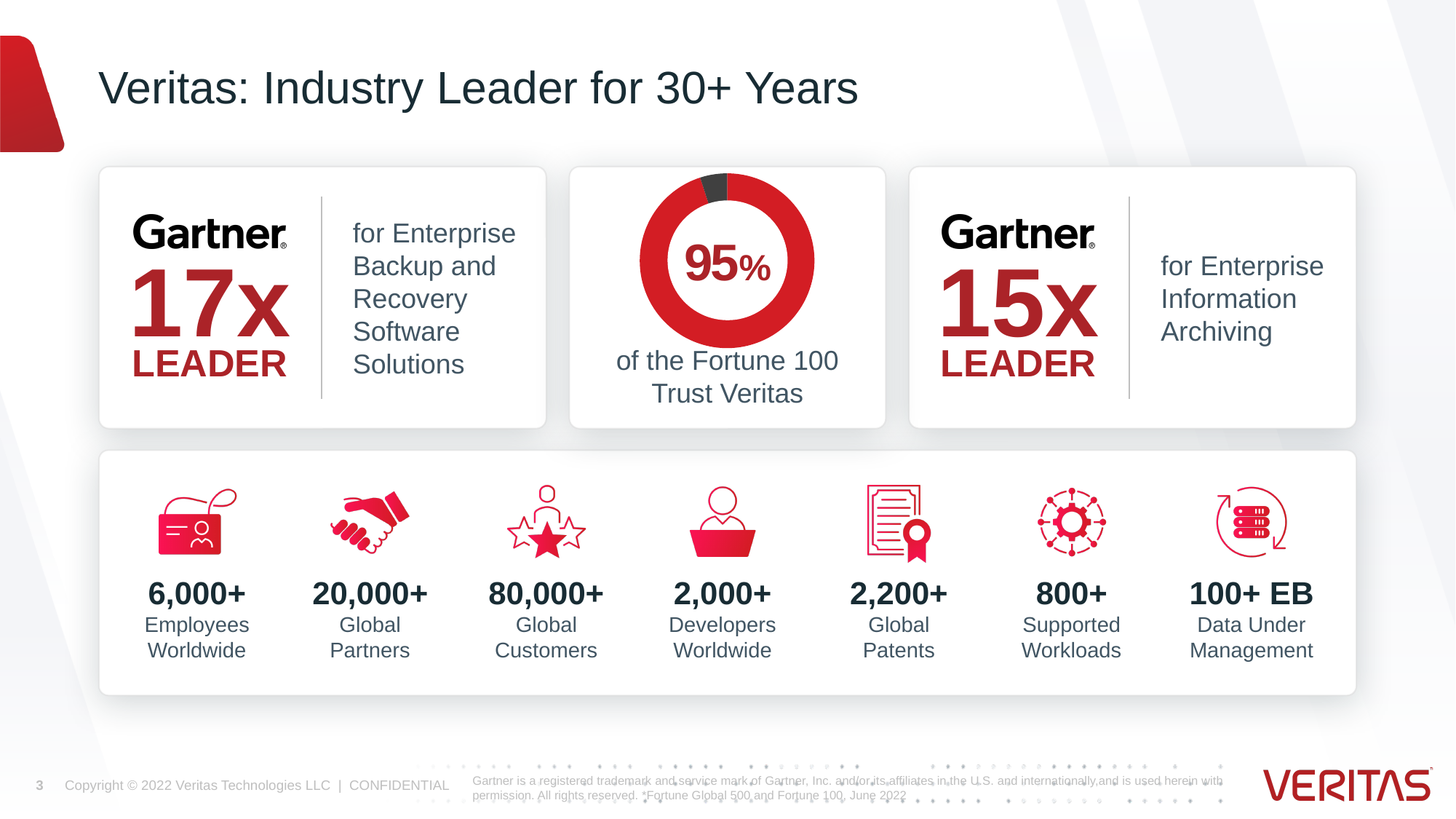
How many segments does the donut chart have? 2 What share of the donut chart is filled by the red segment? 95% What colour is the large segment of the donut chart? Red What text appears below the donut chart describing what the 95% refers to? of the Fortune 100 Trust Veritas What share of the donut chart is taken up by the small dark grey segment? 5% What percentage of the Fortune 100 trust Veritas, according to the donut chart? 95% Is the value shown in the donut chart greater or less than 50%? greater What kind of chart is shown in the middle panel of the slide? Donut chart